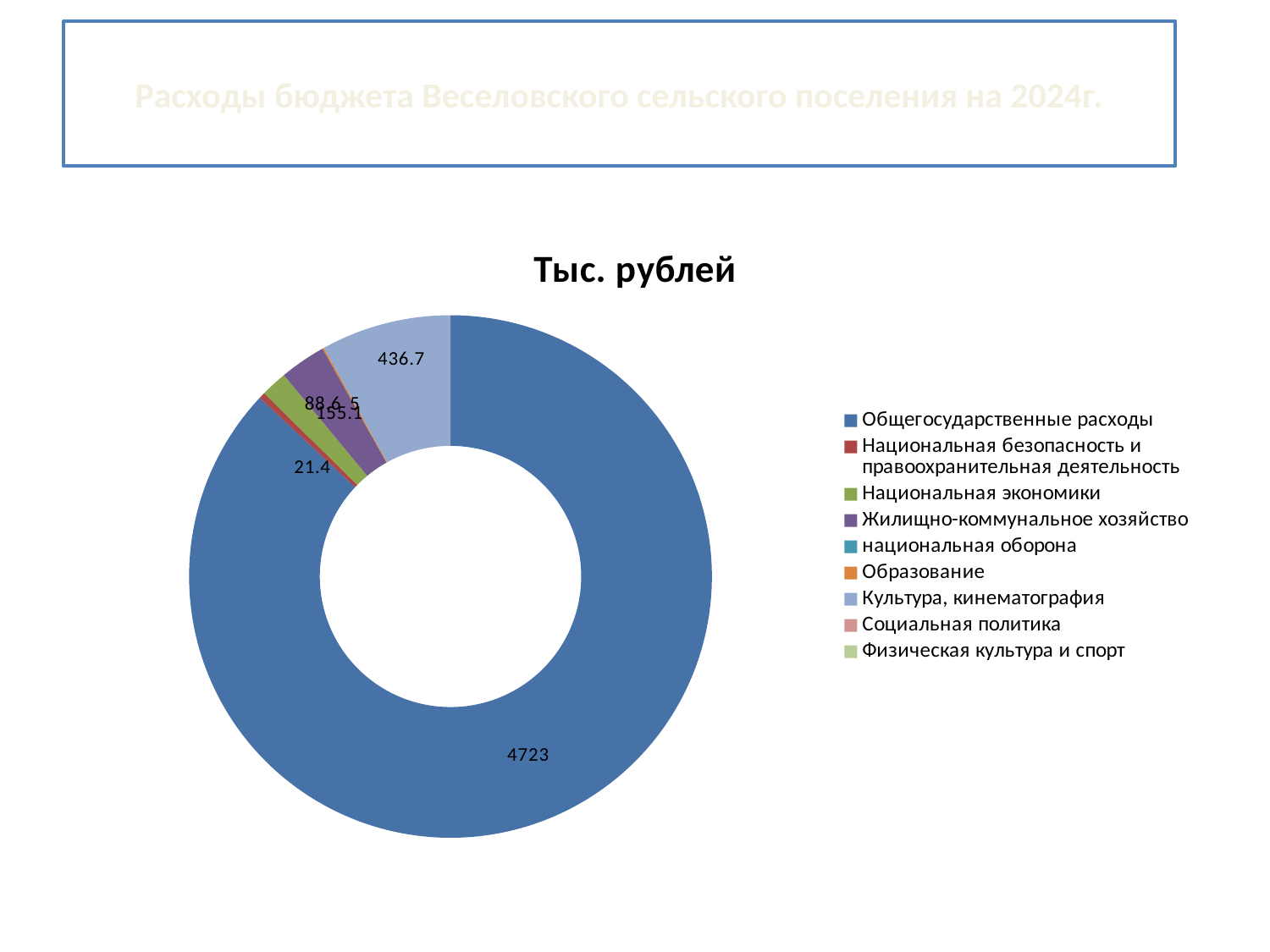
What kind of chart is shown on the slide? Doughnut (pie) chart What is the value for Жилищно-коммунальное хозяйство? 155.1 What is the value for Культура, кинематография? 436.7 Which is larger: Общегосударственные расходы or Культура, кинематография? Общегосударственные расходы What colour represents Общегосударственные расходы in the chart? Blue What is the value for Национальная безопасность и правоохранительная деятельность? 21.4 Which category has the largest slice in the chart? Общегосударственные расходы Which is larger: Культура, кинематография or Национальная безопасность и правоохранительная деятельность? Культура, кинематография What is the difference between the values for Общегосударственные расходы and Культура, кинематография? 4286.3 How many categories does the chart legend list? 9 What is the title of the chart? Тыс. рублей What is the value for Общегосударственные расходы? 4723